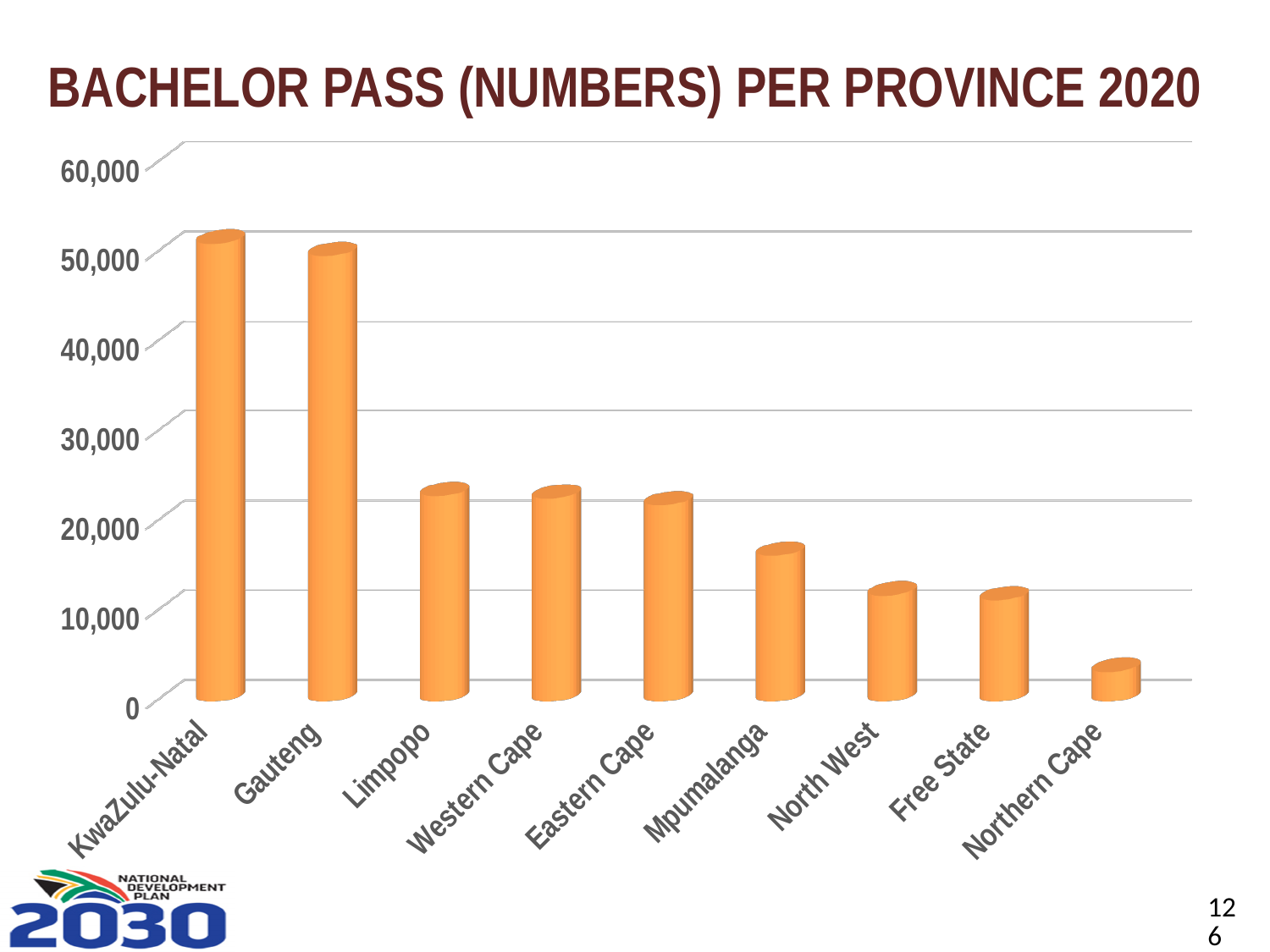
Which province has the lowest number of bachelor passes? Northern Cape Is the value for North West greater or less than 10,000? greater Is the value for Limpopo greater or less than 20,000? greater Is the value for Northern Cape greater or less than 10,000? less What type of chart is shown on the slide? Bar chart Do the values rise or fall moving from left to right across the provinces? Fall Which has more bachelor passes, Limpopo or Mpumalanga? Limpopo How many provinces are shown on the chart? 9 What is the title of the chart? BACHELOR PASS (NUMBERS) PER PROVINCE 2020 Which province has the highest number of bachelor passes? KwaZulu-Natal